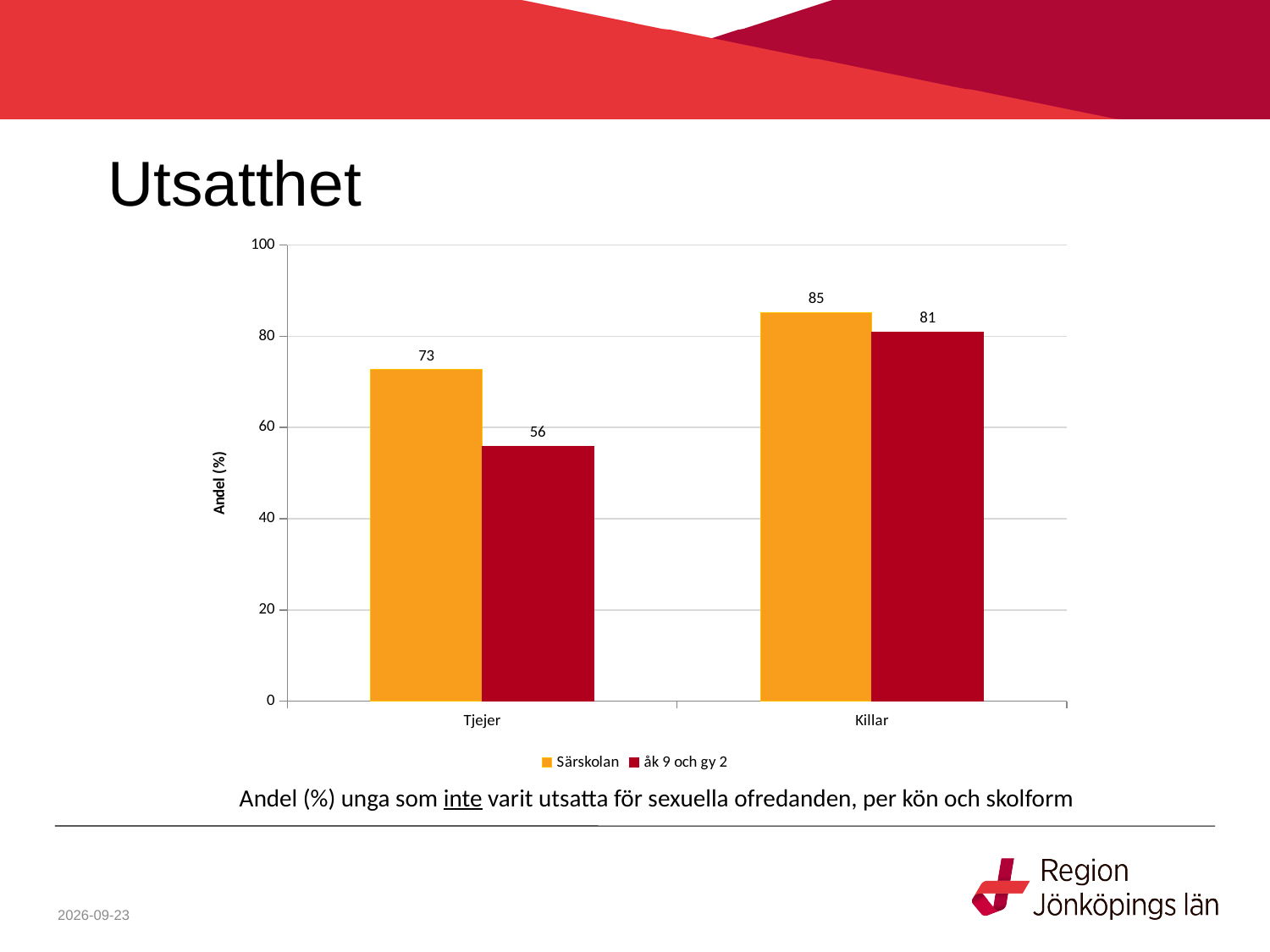
What is the difference between the Särskolan and åk 9 och gy 2 values for Killar? 4 What is the value for Särskolan in the Killar category? 85 What is the value for åk 9 och gy 2 in the Tjejer category? 56 How many categories are shown on the x axis? 2 Which is larger for Tjejer: the Särskolan value or the åk 9 och gy 2 value? Särskolan Which category has the lowest value for the åk 9 och gy 2 series? Tjejer How many series does the legend list? 2 What is the value for åk 9 och gy 2 in the Killar category? 81 What is the difference between the Särskolan and åk 9 och gy 2 values for Tjejer? 17 Which category has the highest value for the Särskolan series? Killar What is the value for Särskolan in the Tjejer category? 73 What kind of chart is shown on the slide? Bar chart